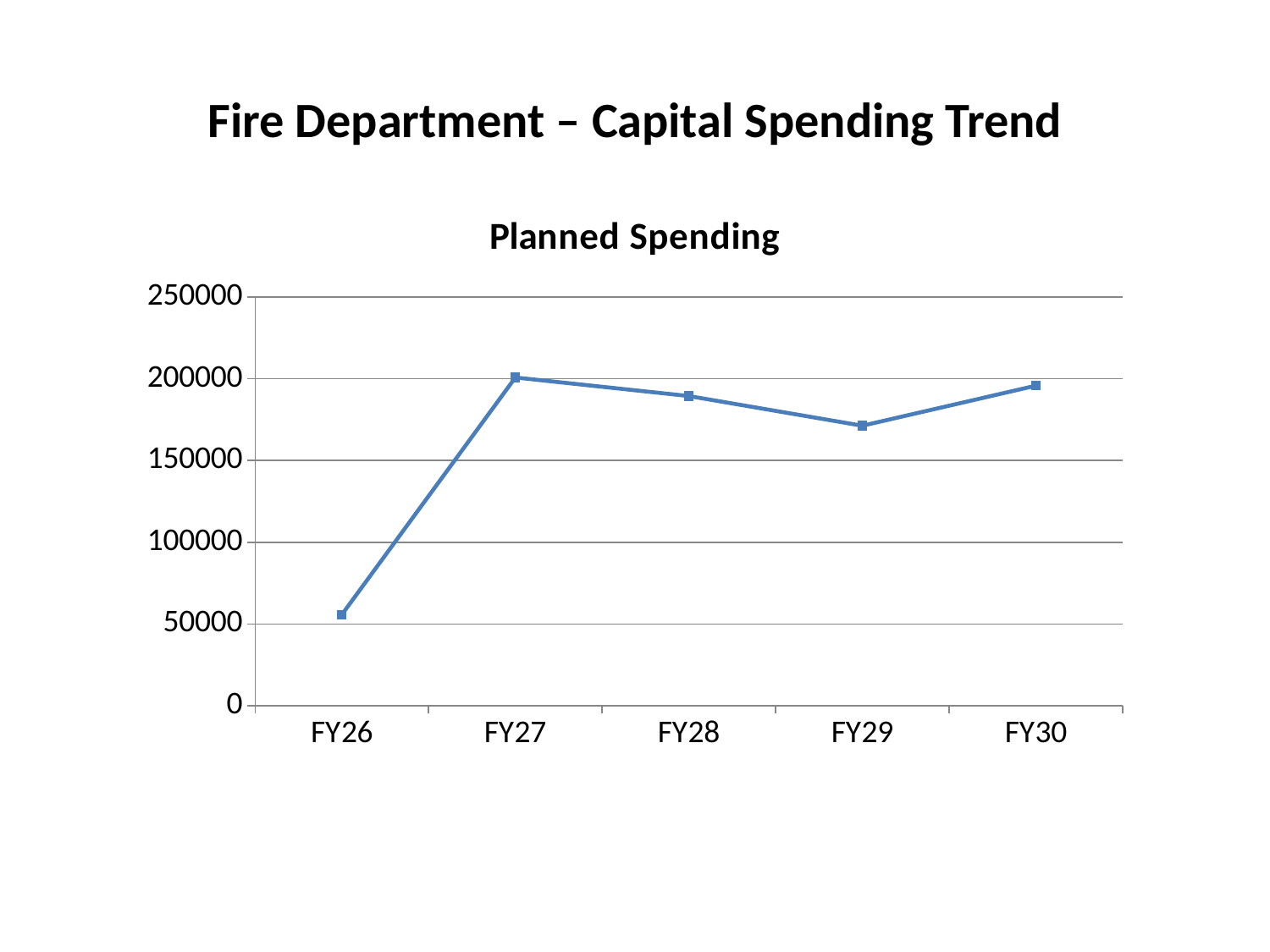
Which fiscal year has the lowest planned spending? FY26 Is the value for FY28 greater or less than 150000? greater Is the value for FY26 greater or less than 100000? less What kind of chart is shown on the slide? line chart Is the value for FY29 greater or less than 150000? greater How many fiscal years are plotted on the x axis? 5 Does planned spending rise or fall from FY26 to FY27? rise What is the title of the chart? Planned Spending Which is larger, the value for FY26 or the value for FY28? FY28 Which is larger, the value for FY27 or the value for FY29? FY27 Does planned spending rise or fall from FY27 to FY29? fall